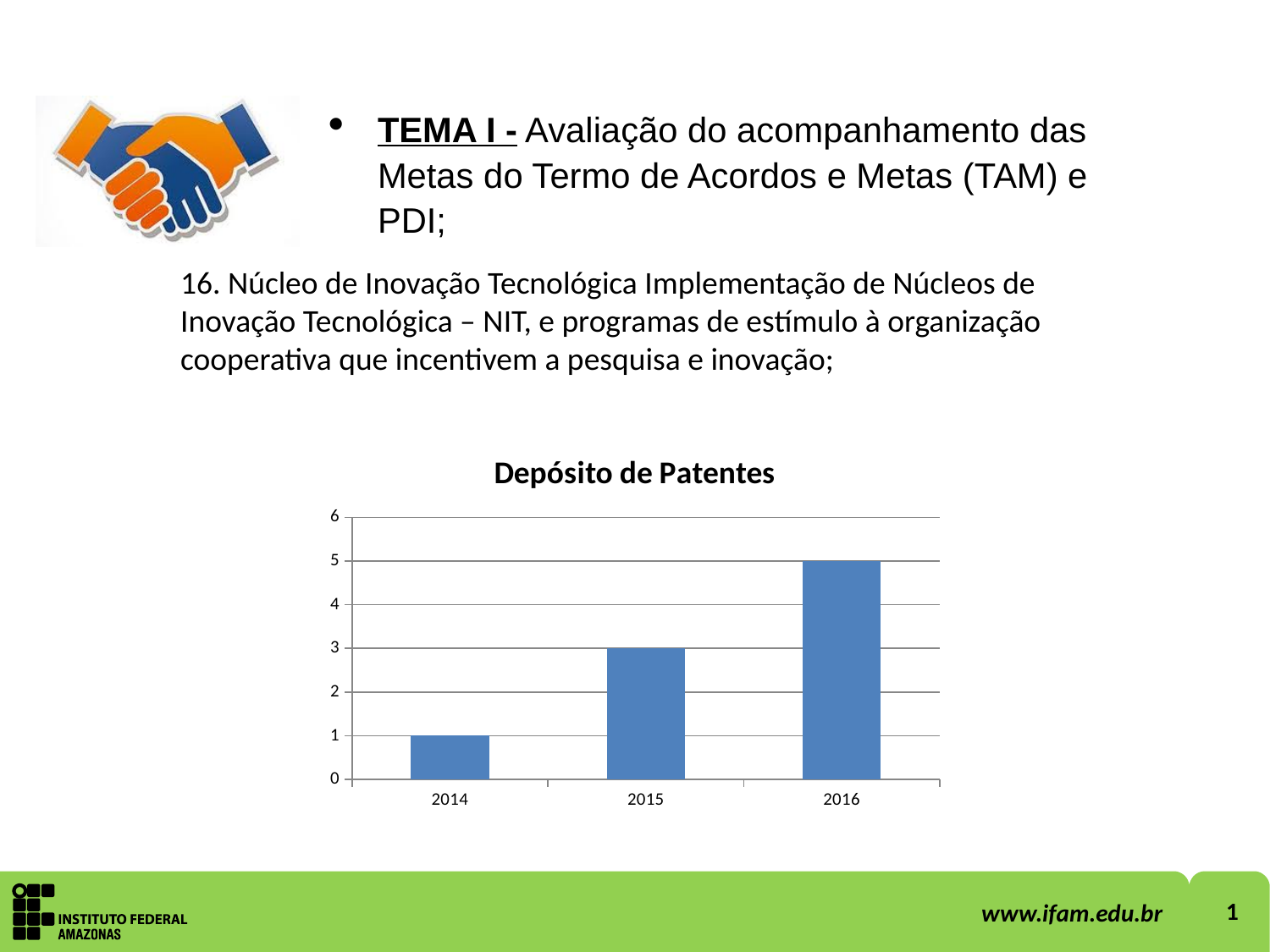
Which year has the highest value in the Depósito de Patentes chart? 2016 Which year has the lowest value in the Depósito de Patentes chart? 2014 What kind of chart is the Depósito de Patentes chart? bar chart What is the difference between the values for 2016 and 2014 in the Depósito de Patentes chart? 4 Do the values in the Depósito de Patentes chart rise or fall from 2014 to 2016? rise Is the value for 2016 in the Depósito de Patentes chart greater or less than 4? greater What is the value for 2015 in the Depósito de Patentes chart? 3 What is the difference between the values for 2015 and 2014 in the Depósito de Patentes chart? 2 What is the value for 2016 in the Depósito de Patentes chart? 5 Which is larger in the Depósito de Patentes chart, the value for 2015 or the value for 2016? 2016 What is the value for 2014 in the Depósito de Patentes chart? 1 How many years are shown on the x axis of the Depósito de Patentes chart? 3